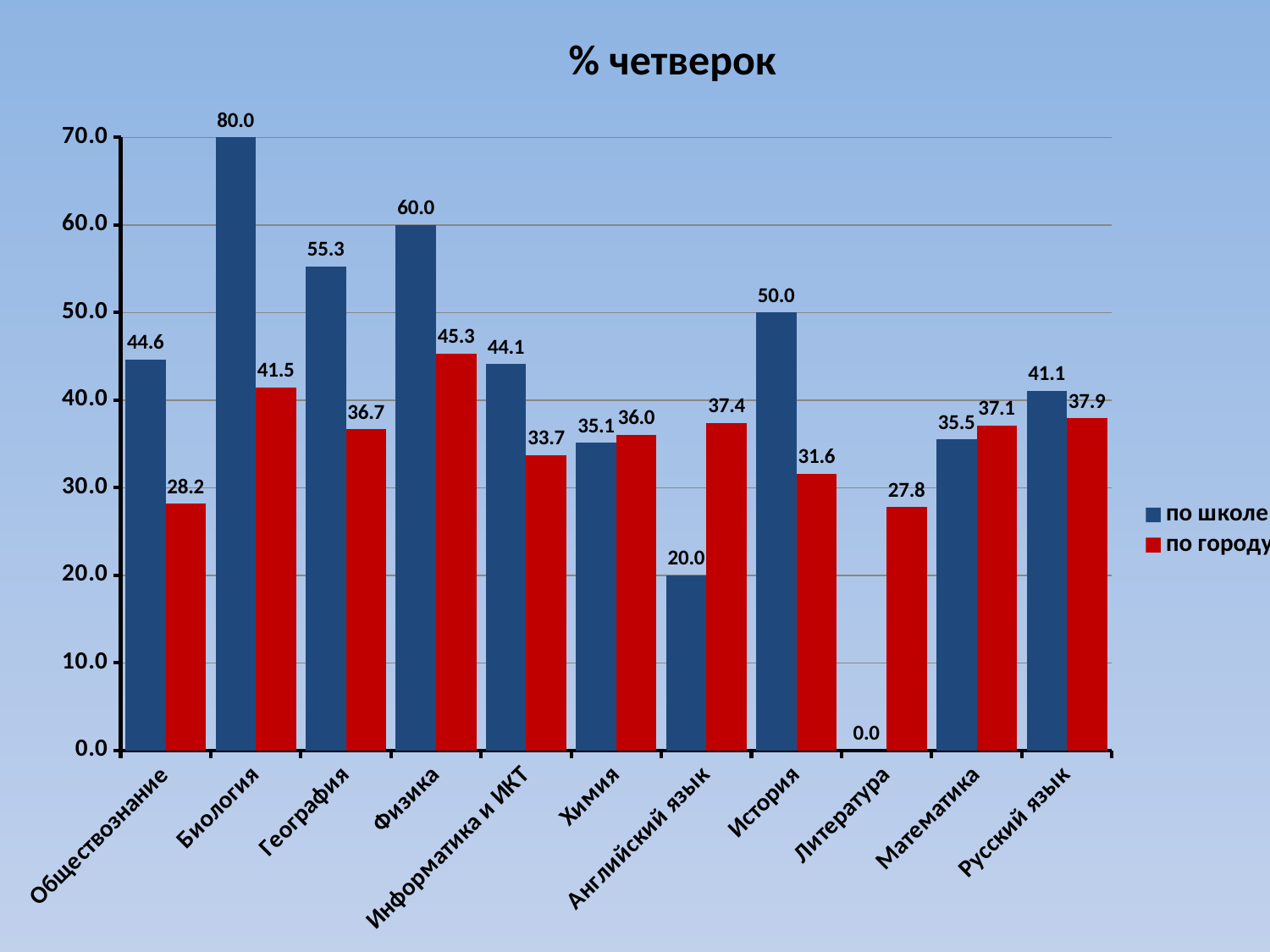
How many series does the legend list? 2 Which category has the highest value in the по городу series? Физика What is the title of the chart? % четверок What is the value for Биология in the по школе series? 80.0 What is the difference between the по школе and по городу values for Обществознание? 16.4 Which is larger for Английский язык: the по школе value or the по городу value? по городу What is the value for Английский язык in the по школе series? 20.0 Which category has the lowest value in the по школе series? Литература How many categories are shown on the x axis? 11 What is the value for Литература in the по городу series? 27.8 What kind of chart is shown on the slide? bar chart Which category has the highest value in the по школе series? Биология